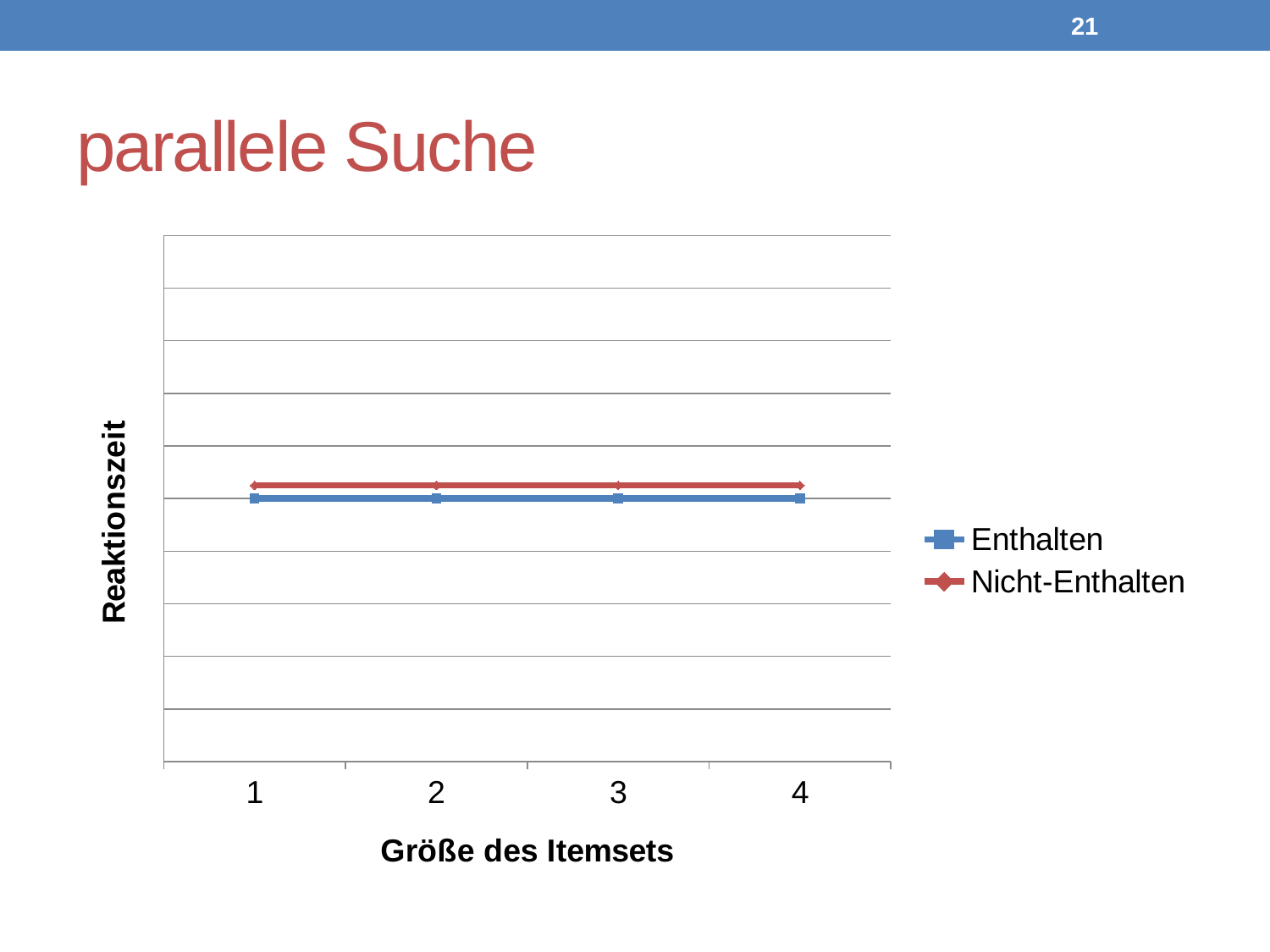
How many series does the legend list? 2 What is the label of the y axis? Reaktionszeit Does the Nicht-Enthalten series rise, fall or stay flat as Größe des Itemsets increases from 1 to 4? stays flat What kind of chart is shown on the slide? line chart Which series has the lower Reaktionszeit at Größe des Itemsets 4, Enthalten or Nicht-Enthalten? Enthalten What are the x-axis category values shown? 1, 2, 3, 4 Does the Enthalten series rise, fall or stay flat as Größe des Itemsets increases from 1 to 4? stays flat Which series has the higher Reaktionszeit at Größe des Itemsets 1, Enthalten or Nicht-Enthalten? Nicht-Enthalten What is the label of the x axis? Größe des Itemsets How many points along the x axis does each series have? 4 Which series is plotted above the other across all item set sizes? Nicht-Enthalten